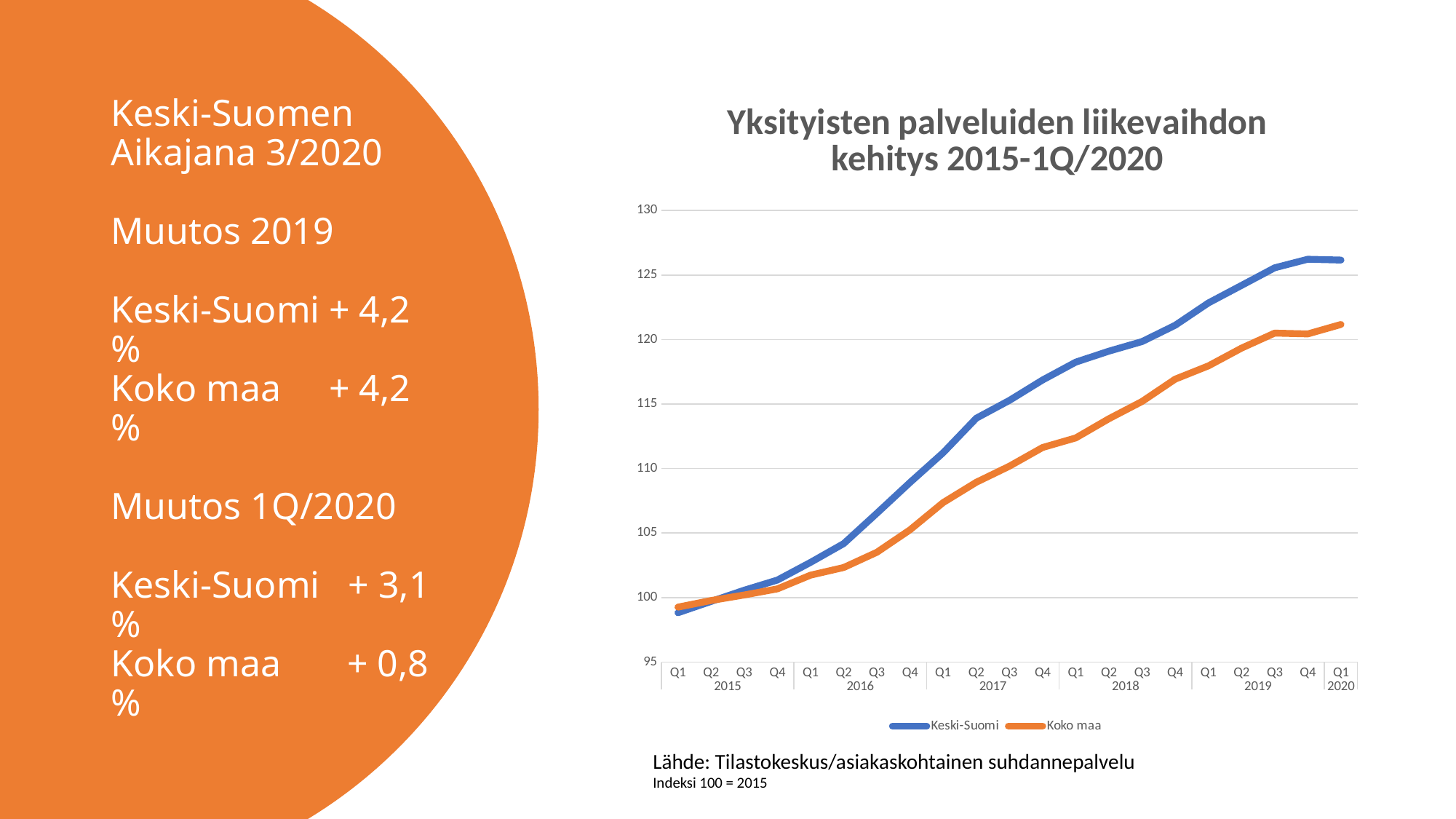
Which series has the higher value in Q1 2020, Keski-Suomi or Koko maa? Keski-Suomi Which series has the higher value in Q2 2018, Keski-Suomi or Koko maa? Keski-Suomi How many series does the legend of the chart list? 2 Is the value for Koko maa in Q1 2020 greater or less than 120? greater Is the value for Keski-Suomi in Q1 2015 greater or less than 100? less What are the two series named in the chart legend? Keski-Suomi and Koko maa What is the title of the chart? Yksityisten palveluiden liikevaihdon kehitys 2015-1Q/2020 How many quarterly points are plotted along the x axis of the chart? 21 Do the values of the Keski-Suomi series rise or fall from Q1 2015 to Q1 2020? rise Is the value for Koko maa in Q4 2018 greater or less than 120? less What kind of chart is shown on the slide? line chart